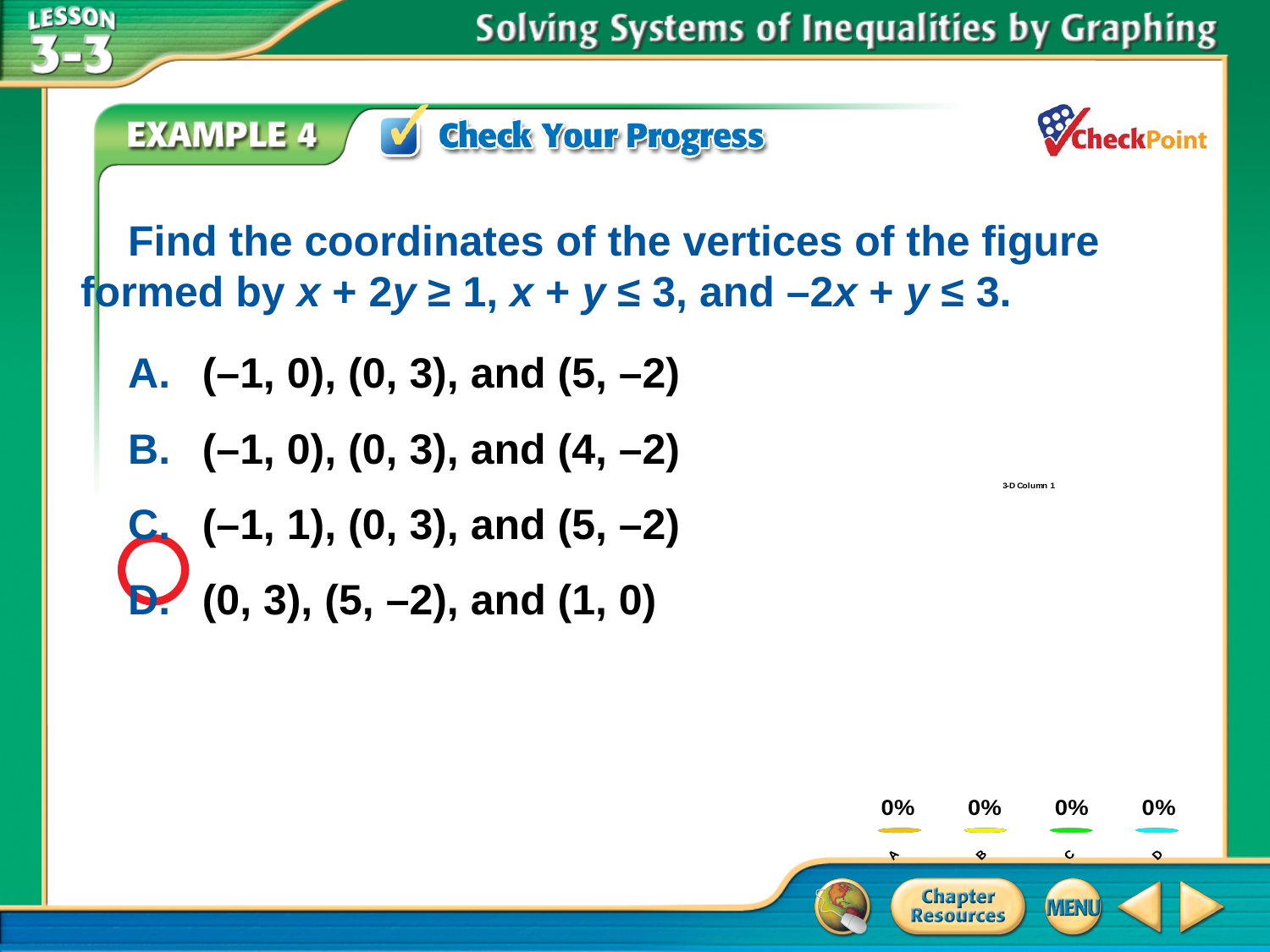
What is the difference between the values for A and D in the chart? 0% What is the value shown for category C in the chart? 0% What is the value shown for category D in the chart? 0% Do the values in the chart rise, fall, or stay the same from A to D? stay the same What kind of chart is shown on the slide? bar chart What are the category labels along the x axis of the chart? A, B, C, D What is the difference between the values for B and C in the chart? 0% What is the value shown for category B in the chart? 0% What text label appears above the chart? 3-D Column 1 What is the value shown for category A in the chart? 0% How many categories are shown on the x axis of the chart? 4